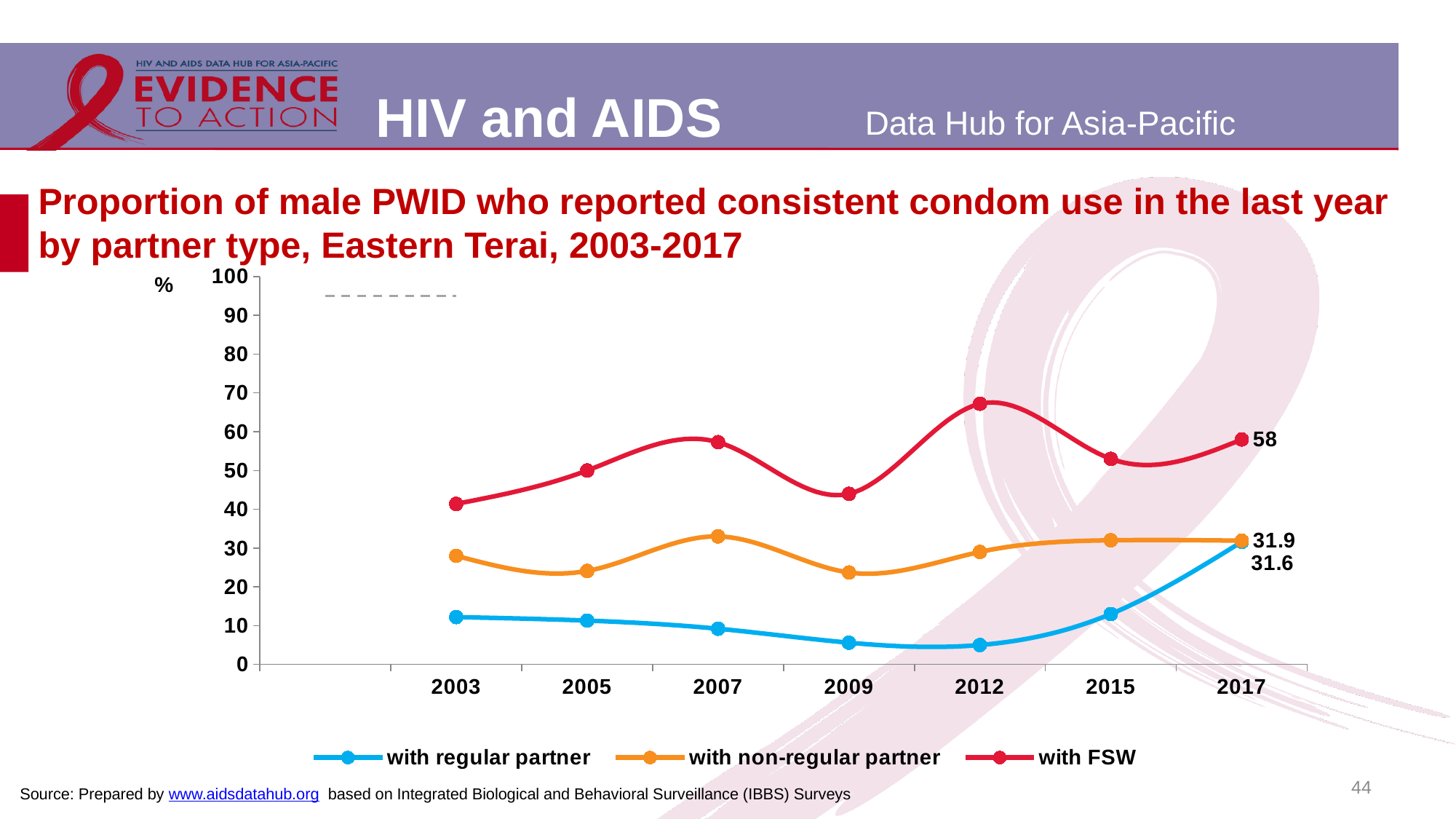
What is the value for 'with FSW' in 2017? 58 What is the difference between the highest and lowest values labelled for 2017? 26.4 What type of chart is shown on the slide? line chart Is the value for 'with regular partner' in 2012 greater or less than 10? less How many series does the legend list? 3 In which year does the 'with FSW' series reach its highest value? 2012 How many years are plotted along the x axis? 7 Does the 'with regular partner' series rise or fall from 2003 to 2012? fall Is the value for 'with FSW' in 2012 greater or less than 60? greater Which is larger in 2005, the value for 'with FSW' or the value for 'with regular partner'? with FSW Is the value for 'with non-regular partner' in 2007 greater or less than 30? greater Which series is shown in red in the legend? with FSW